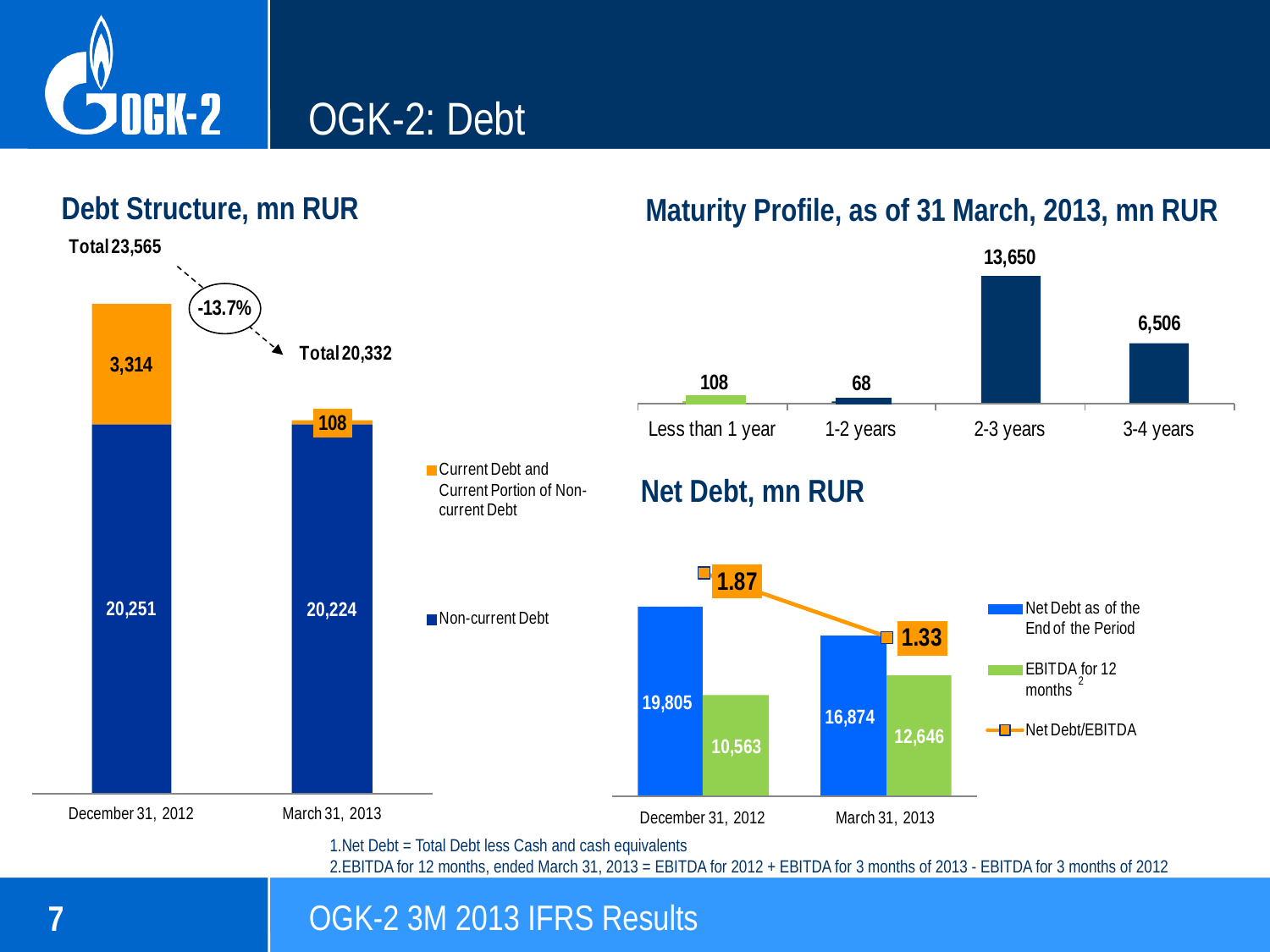
In the Debt Structure chart, what is the Current Debt and Current Portion of Non-current Debt value for March 31, 2013? 108 In the Debt Structure chart, how many series does the legend list? 2 In the Debt Structure chart, what is the difference between the Non-current Debt values for December 31, 2012 and March 31, 2013? 27 In the Maturity Profile chart, how many maturity buckets are shown? 4 In the Net Debt chart, what is the EBITDA for 12 months value for December 31, 2012? 10,563 In the Net Debt chart, is Net Debt as of the End of the Period larger for December 31, 2012 or March 31, 2013? December 31, 2012 In the Debt Structure chart, what is the total debt shown for December 31, 2012? 23,565 In the Maturity Profile chart, which maturity bucket has the lowest value? 1-2 years In the Net Debt chart, what is the Net Debt/EBITDA ratio for March 31, 2013? 1.33 In the Maturity Profile chart, what is the value for 3-4 years? 6,506 In the Debt Structure chart, what is the Non-current Debt value for December 31, 2012? 20,251 In the Maturity Profile chart, which maturity bucket has the highest value? 2-3 years